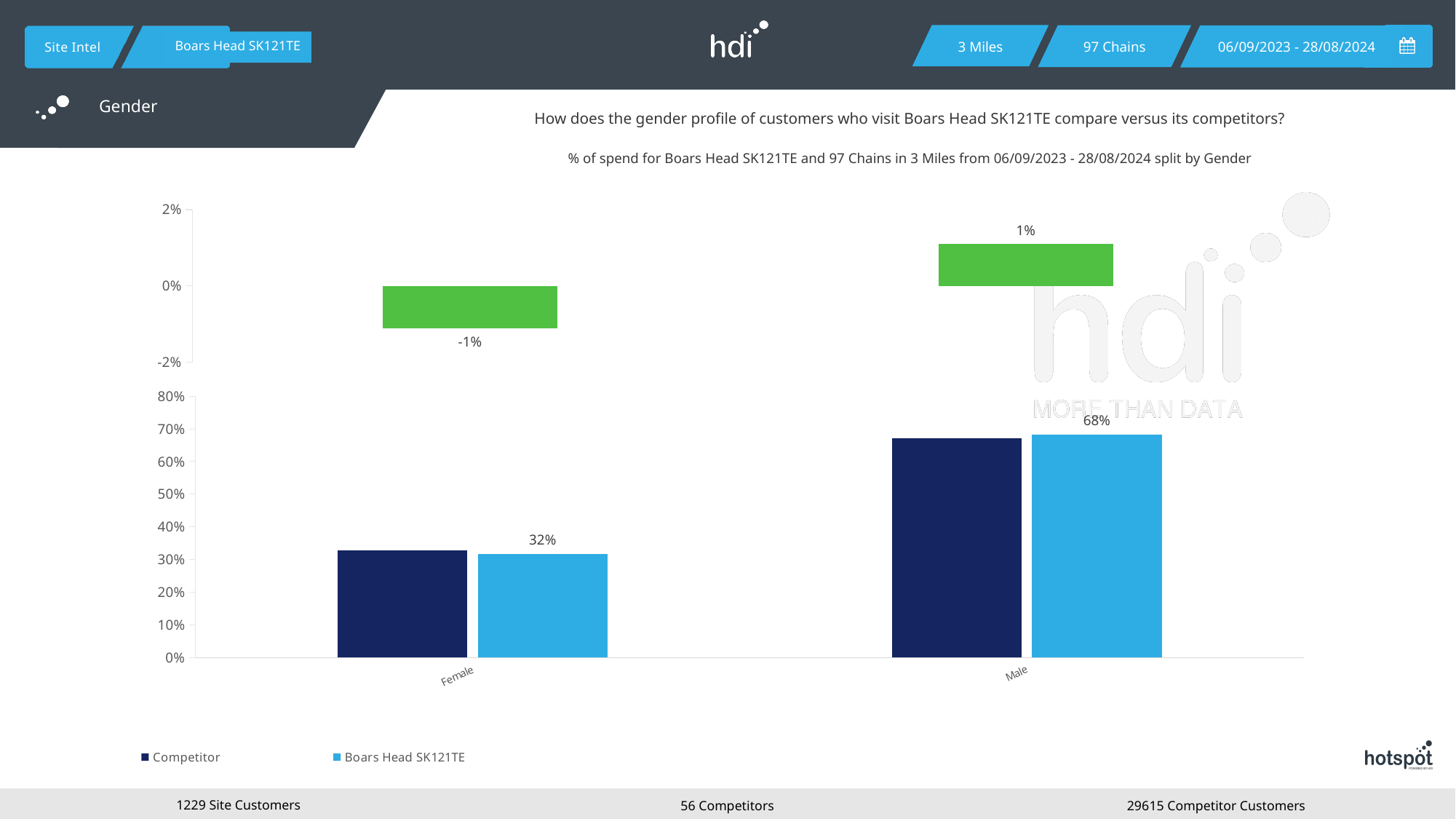
In the bottom bar chart, what is the value for Boars Head SK121TE in the Male category? 68% In the bottom bar chart, what is the difference between the Boars Head SK121TE values for Male and Female? 36% In the bottom bar chart, which category has the higher value for Boars Head SK121TE, Female or Male? Male In the bottom bar chart, what is the value for Boars Head SK121TE in the Female category? 32% What type of chart is the bottom chart on the slide? Bar chart How many series does the legend of the bottom bar chart list? 2 How many categories are shown on the x axis of the bottom bar chart? 2 In the top chart with green bars, what is the value shown for Male? 1% In the bottom bar chart, is the Competitor value for Male greater or less than 60%? greater In the top chart with green bars, what is the value shown for Female? -1% In the bottom bar chart, is the Competitor value for Female greater or less than 40%? less In the bottom bar chart, which series is shown in dark navy blue according to the legend? Competitor